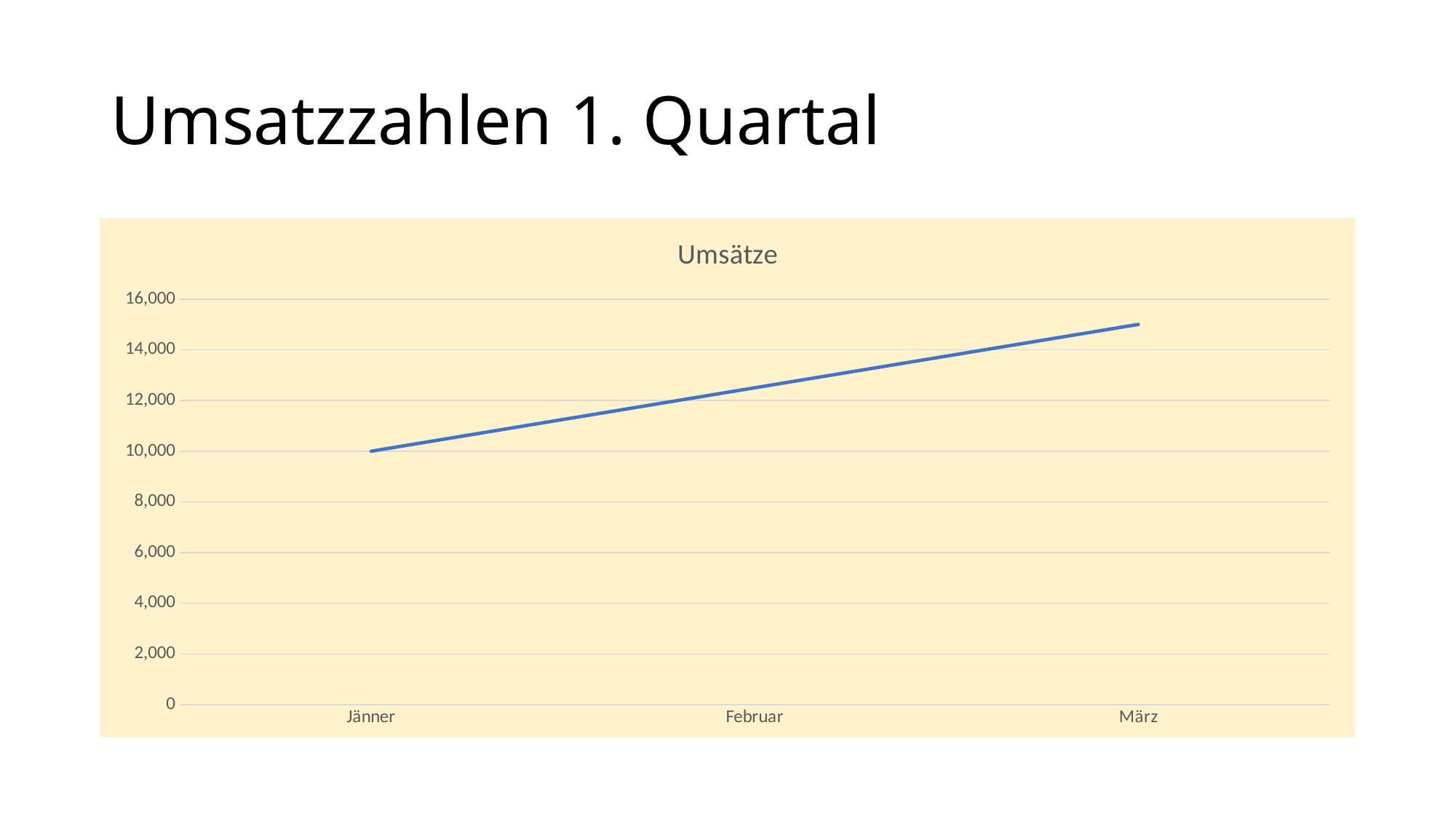
Which month has the lowest value? Jänner What is the title of the chart? Umsätze How many months are plotted on the x axis? 3 What type of chart is shown on the slide? line chart Which is larger, the value for Februar or the value for März? März Is the value for Februar greater or less than 12,000? greater What is the highest value shown on the y axis? 16,000 Do the values rise or fall from Jänner to März? rise Is the value for März greater or less than 14,000? greater What is the value for Jänner? 10,000 Which month has the highest value? März Is the value for Februar greater or less than 14,000? less